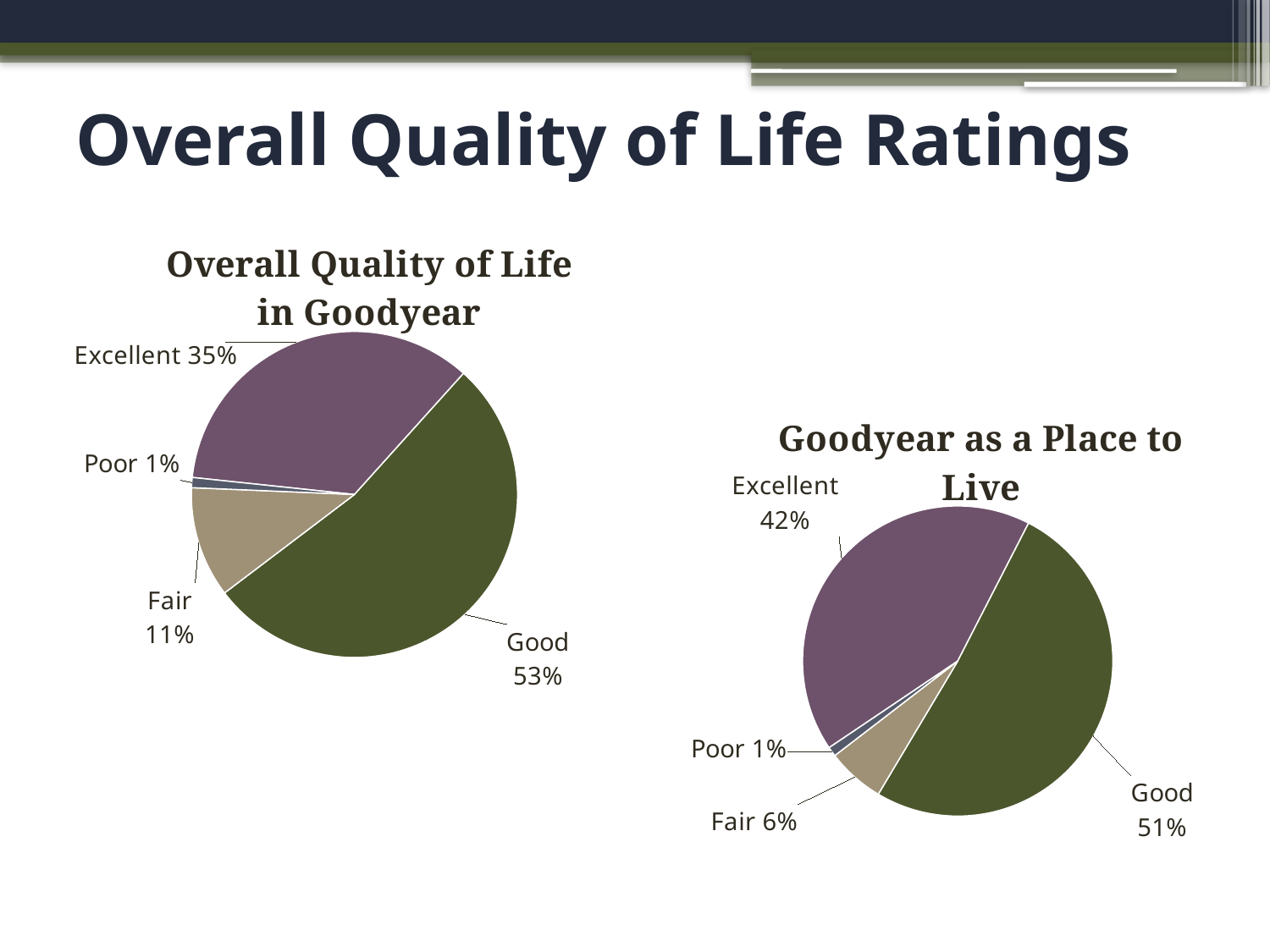
Which is larger: the Excellent share in the 'Overall Quality of Life in Goodyear' chart or the Excellent share in the 'Goodyear as a Place to Live' chart? Goodyear as a Place to Live In the 'Overall Quality of Life in Goodyear' chart, what percentage rated quality of life as Excellent? 35% What type of chart is the 'Goodyear as a Place to Live' chart? Pie chart What is the title of the chart on the left side of the slide? Overall Quality of Life in Goodyear In the 'Overall Quality of Life in Goodyear' chart, what percentage rated quality of life as Good? 53% In the 'Goodyear as a Place to Live' chart, what is the difference between the Good and Fair shares? 45% How many categories are shown in the 'Overall Quality of Life in Goodyear' chart? 4 In the 'Goodyear as a Place to Live' chart, what percentage rated it Excellent? 42% In the 'Overall Quality of Life in Goodyear' chart, what is the difference between the Good and Excellent shares? 18% In the 'Goodyear as a Place to Live' chart, what percentage rated it Fair? 6% In the 'Overall Quality of Life in Goodyear' chart, which rating has the largest share? Good In the 'Goodyear as a Place to Live' chart, which rating has the smallest share? Poor